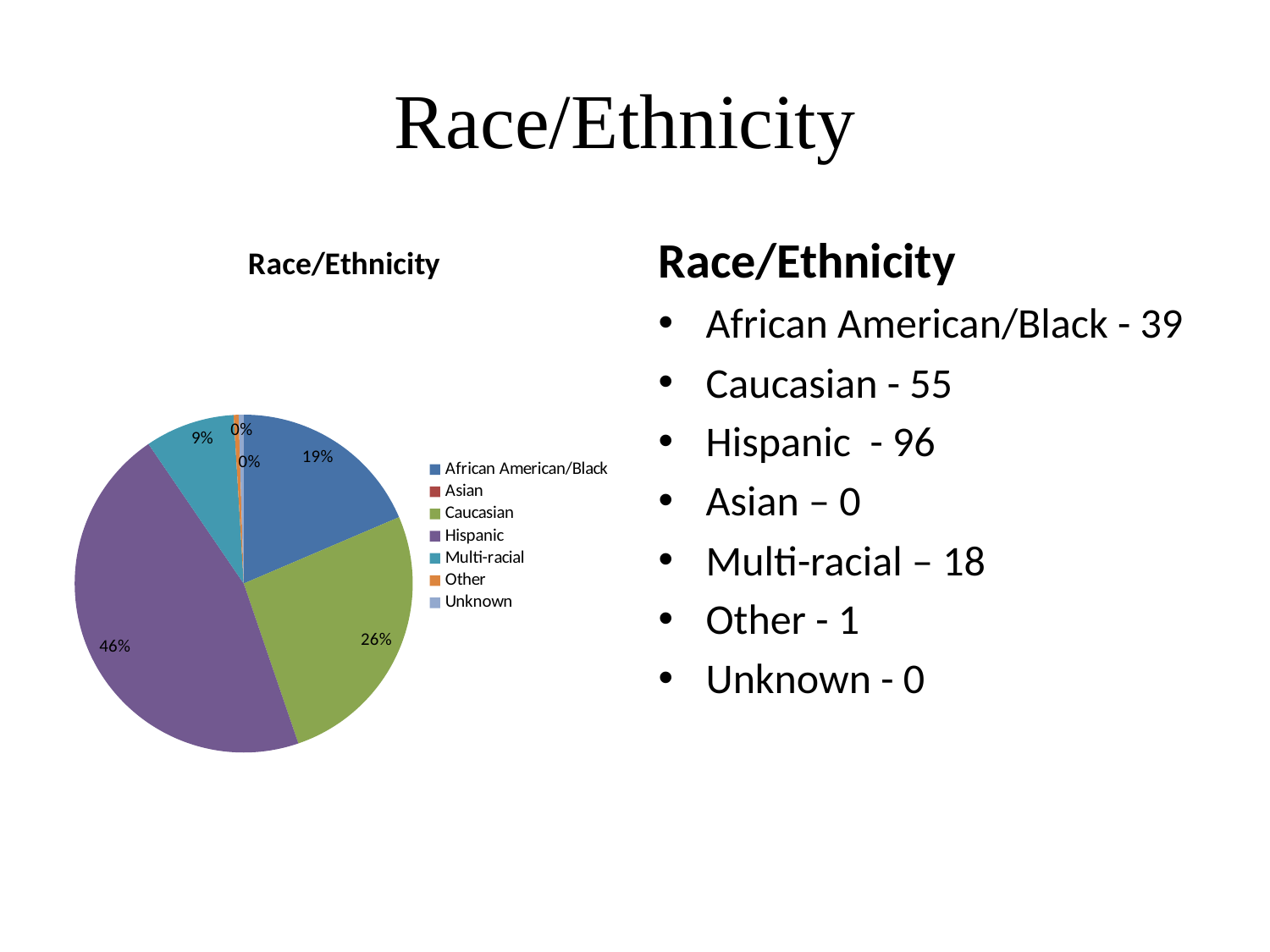
By how many percentage points does the Caucasian share exceed the Multi-racial share? 17 percentage points By how many percentage points does the Hispanic share exceed the Caucasian share? 20 percentage points Which is larger, the Multi-racial slice or the Hispanic slice? Hispanic What is the chart's title? Race/Ethnicity Which category has the largest slice of the pie? Hispanic What share of the pie does Hispanic represent? 46% What share of the pie does Caucasian represent? 26% Which is larger, the Caucasian slice or the African American/Black slice? Caucasian What share of the pie does African American/Black represent? 19% What kind of chart is shown on the slide? pie chart How many categories does the legend of the pie chart list? 7